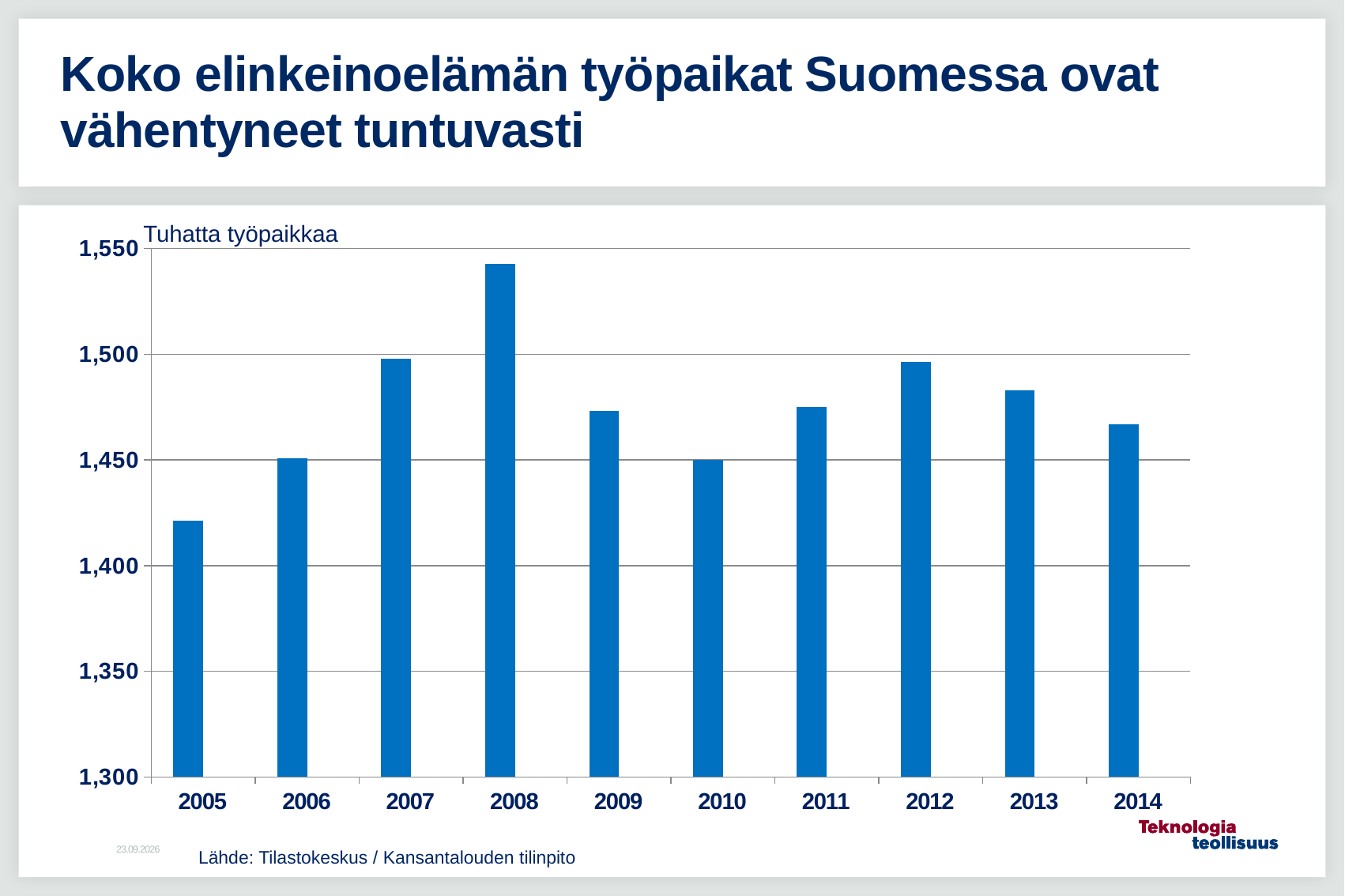
Which year has the highest number of jobs in the chart? 2008 Is the value for 2014 greater or less than 1,450? greater Do the values rise or fall from 2005 to 2008? rise Is the value for 2008 greater or less than 1,500? greater Is the value for 2009 greater or less than 1,450? greater Which year has the larger value, 2007 or 2008? 2008 What kind of chart is shown on the slide? Bar chart Which year has the lowest number of jobs in the chart? 2005 Which year has the larger value, 2013 or 2014? 2013 How many years are shown on the x axis of the chart? 10 What unit label is shown above the y axis of the chart? Tuhatta työpaikkaa